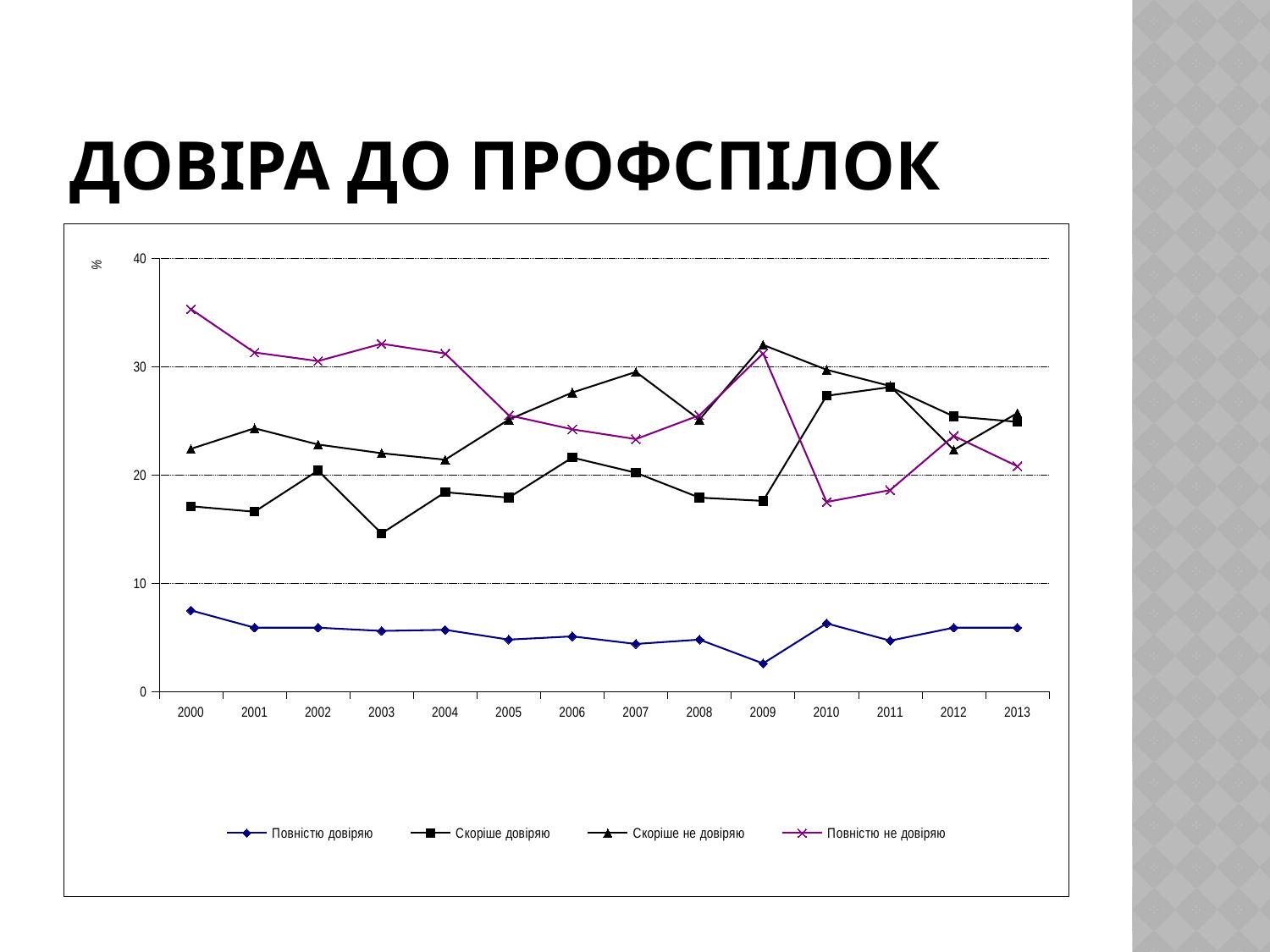
Is the value for "Скоріше довіряю" in 2003 greater or less than 20? less What is the title of the slide above the chart? ДОВІРА ДО ПРОФСПІЛОК What kind of chart is shown on the slide? line chart Is the value for "Повністю не довіряю" in 2000 greater or less than 30? greater In which year is the "Скоріше довіряю" series at its lowest? 2003 Is the value for "Скоріше не довіряю" in 2009 greater or less than 30? greater How many series does the legend list? 4 In which year is the "Повністю не довіряю" series at its highest? 2000 How many years are plotted along the x axis? 14 Does the "Повністю не довіряю" series rise or fall from 2000 to 2005? fall In which year is the "Повністю довіряю" series at its lowest? 2009 In 2010, which is larger: "Скоріше не довіряю" or "Повністю не довіряю"? Скоріше не довіряю